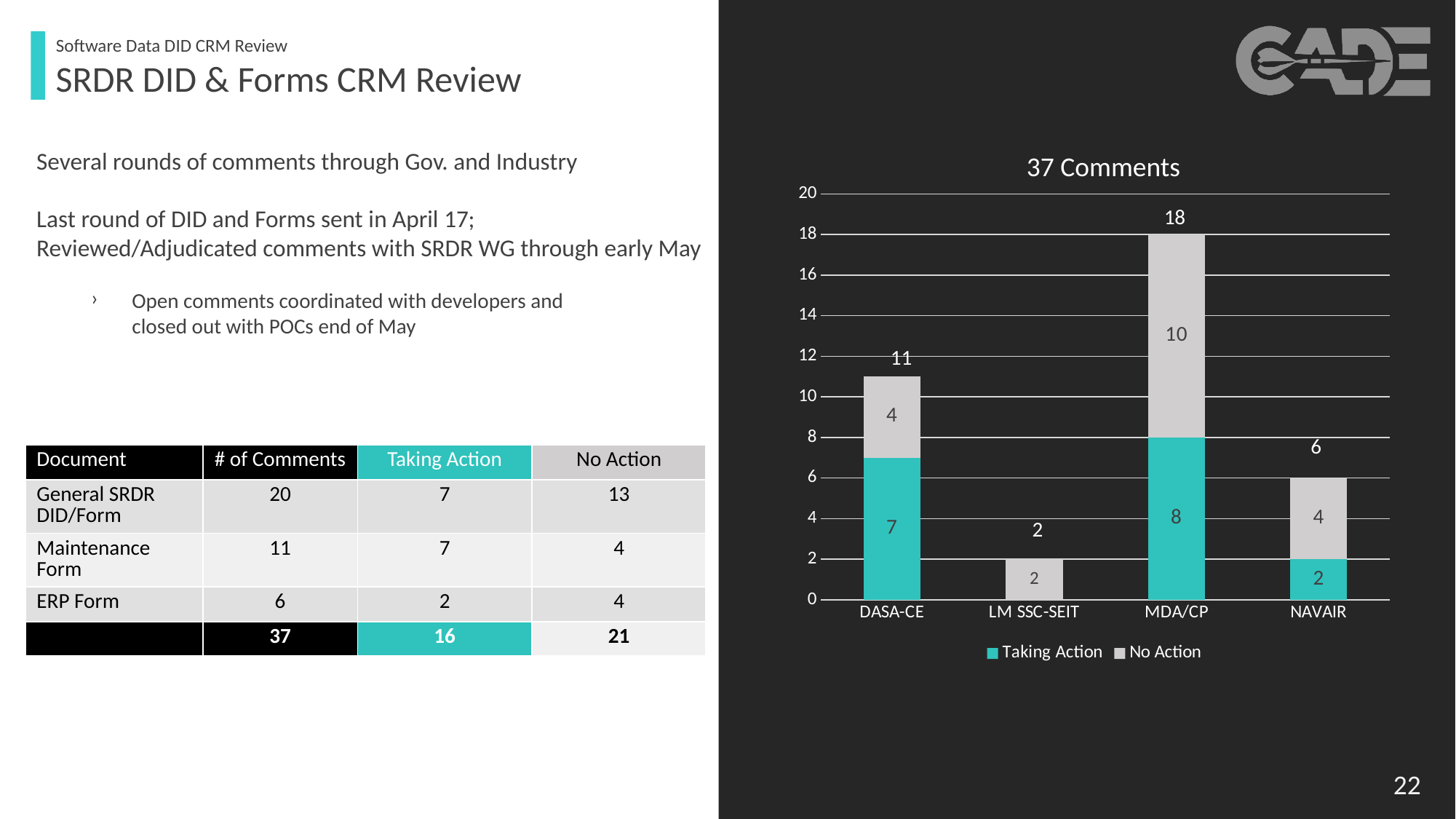
Which category has the highest total number of comments? MDA/CP What is the difference between the total for MDA/CP and the total for NAVAIR? 12 Which is larger, the Taking Action value for MDA/CP or the Taking Action value for DASA-CE? MDA/CP What kind of chart is shown on the slide? Stacked bar chart What is the total of the stacked bar for DASA-CE? 11 What is the No Action value for NAVAIR? 4 How many series does the chart legend list? 2 What is the No Action value for MDA/CP? 10 Which category has the lowest total number of comments? LM SSC-SEIT What is the title of the chart? 37 Comments How many categories are shown on the x axis of the chart? 4 What is the Taking Action value for DASA-CE? 7